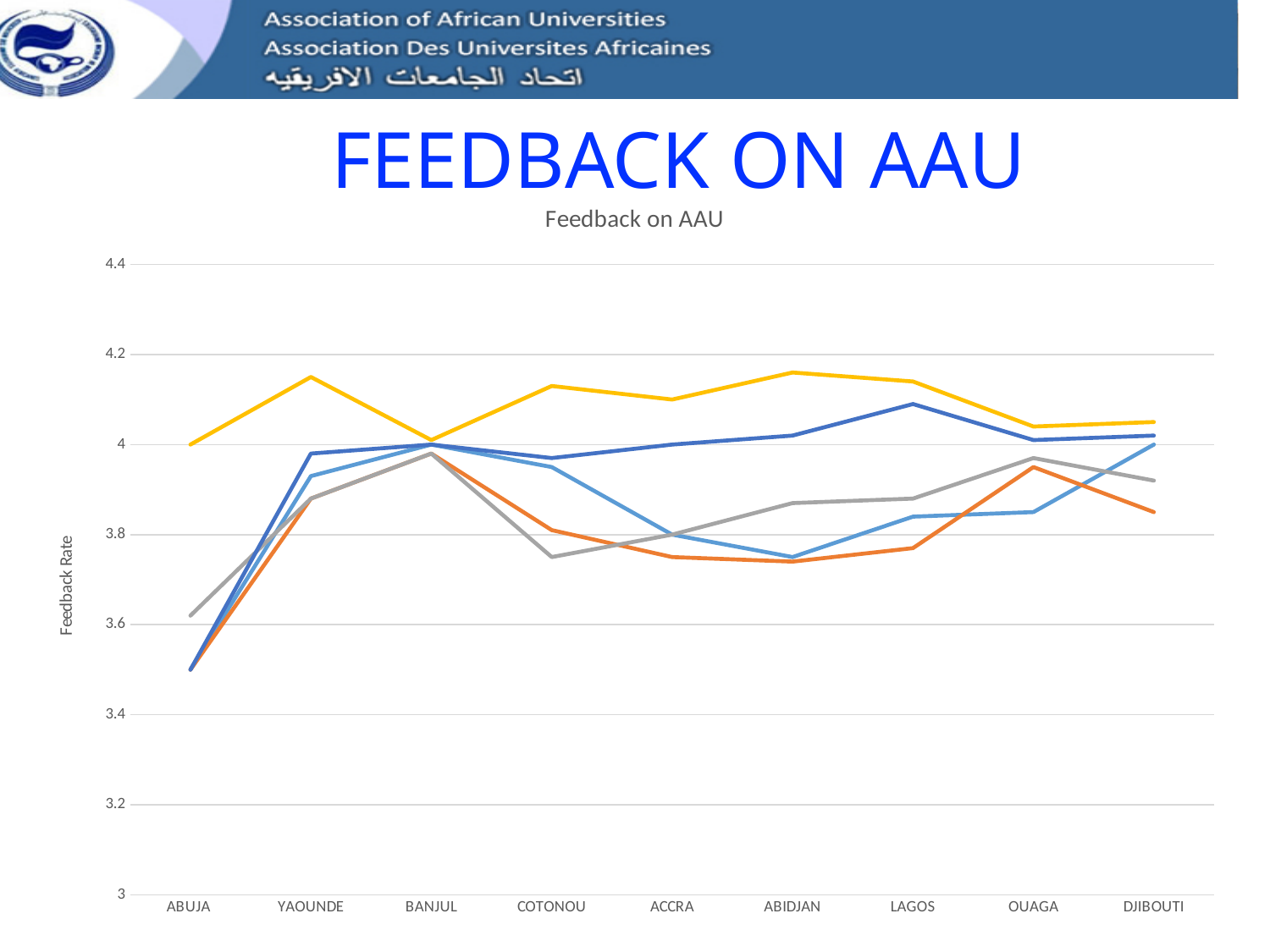
Does the grey line rise or fall from BANJUL to COTONOU? fall How many cities are listed along the x axis of the chart? 9 Is the value of the orange line at ABUJA greater or less than 3.6? less What is the label on the vertical axis of the chart? Feedback Rate Is the value of the orange line at ABIDJAN greater or less than 3.8? less Is the value of the dark blue line at LAGOS greater or less than 4? greater What kind of chart is shown on the slide? line chart What is the title of the chart? Feedback on AAU Does the yellow line rise or fall from ABUJA to YAOUNDE? rise How many lines are plotted on the chart? 5 What is the value of the yellow line at ABUJA? 4